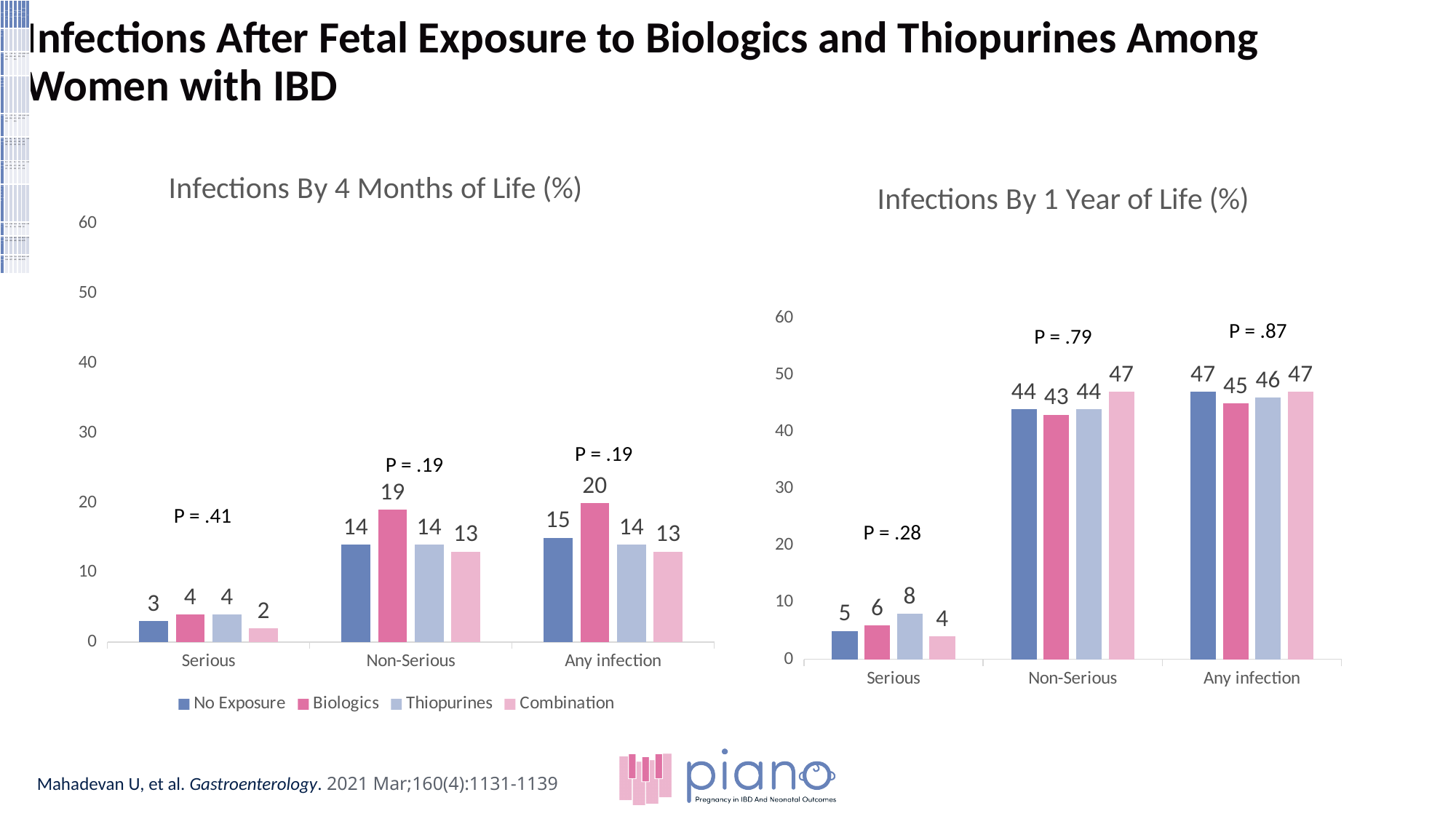
In the 'Infections By 1 Year of Life (%)' chart, which series has the lowest value in the Serious category? Combination In the 'Infections By 4 Months of Life (%)' chart, what P value is shown above the Serious category? P = .41 What type of chart is 'Infections By 1 Year of Life (%)'? Bar chart In the 'Infections By 1 Year of Life (%)' chart, what is the value for Thiopurines in the Serious category? 8 In the 'Infections By 4 Months of Life (%)' chart, which series has the highest value in the Any infection category? Biologics In the 'Infections By 1 Year of Life (%)' chart, what is the difference between the Thiopurines and Combination values in the Serious category? 4 In the 'Infections By 1 Year of Life (%)' chart, is the value for No Exposure in the Any infection category greater or less than 40? greater In the 'Infections By 4 Months of Life (%)' chart, what is the difference between the Biologics and Combination values in the Non-Serious category? 6 In the 'Infections By 1 Year of Life (%)' chart, which is larger in the Non-Serious category: Combination or Biologics? Combination How many series does the legend of the 'Infections By 4 Months of Life (%)' chart list? 4 How many categories are shown on the x axis of the 'Infections By 4 Months of Life (%)' chart? 3 In the 'Infections By 4 Months of Life (%)' chart, what is the value for Biologics in the Non-Serious category? 19